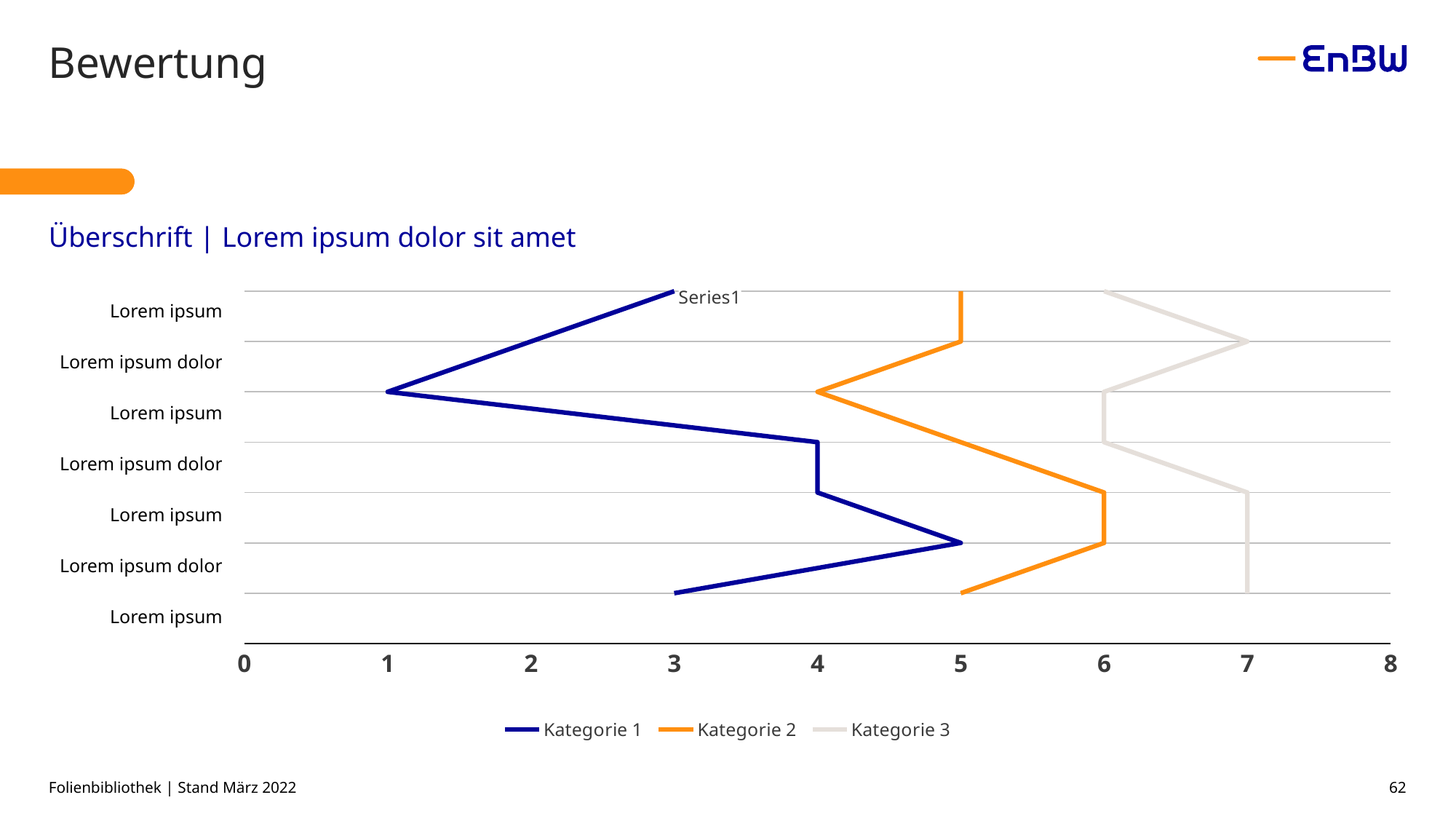
What is the highest value reached by Kategorie 1? 5 Which series reaches the highest value on the x axis? Kategorie 3 How many series does the legend list? 3 What is the lowest value reached by Kategorie 1? 1 What is the difference between the highest value of Kategorie 3 and the lowest value of Kategorie 1? 6 What is the maximum value shown on the x axis? 8 What is the lowest value reached by Kategorie 2? 4 What are the series names listed in the legend? Kategorie 1, Kategorie 2, Kategorie 3 At the topmost point of the chart, which is larger, Kategorie 1 or Kategorie 3? Kategorie 3 What is the value of Kategorie 1 at the topmost point of the chart? 3 What is the highest value reached by Kategorie 3? 7 What kind of chart is shown on the slide? line chart